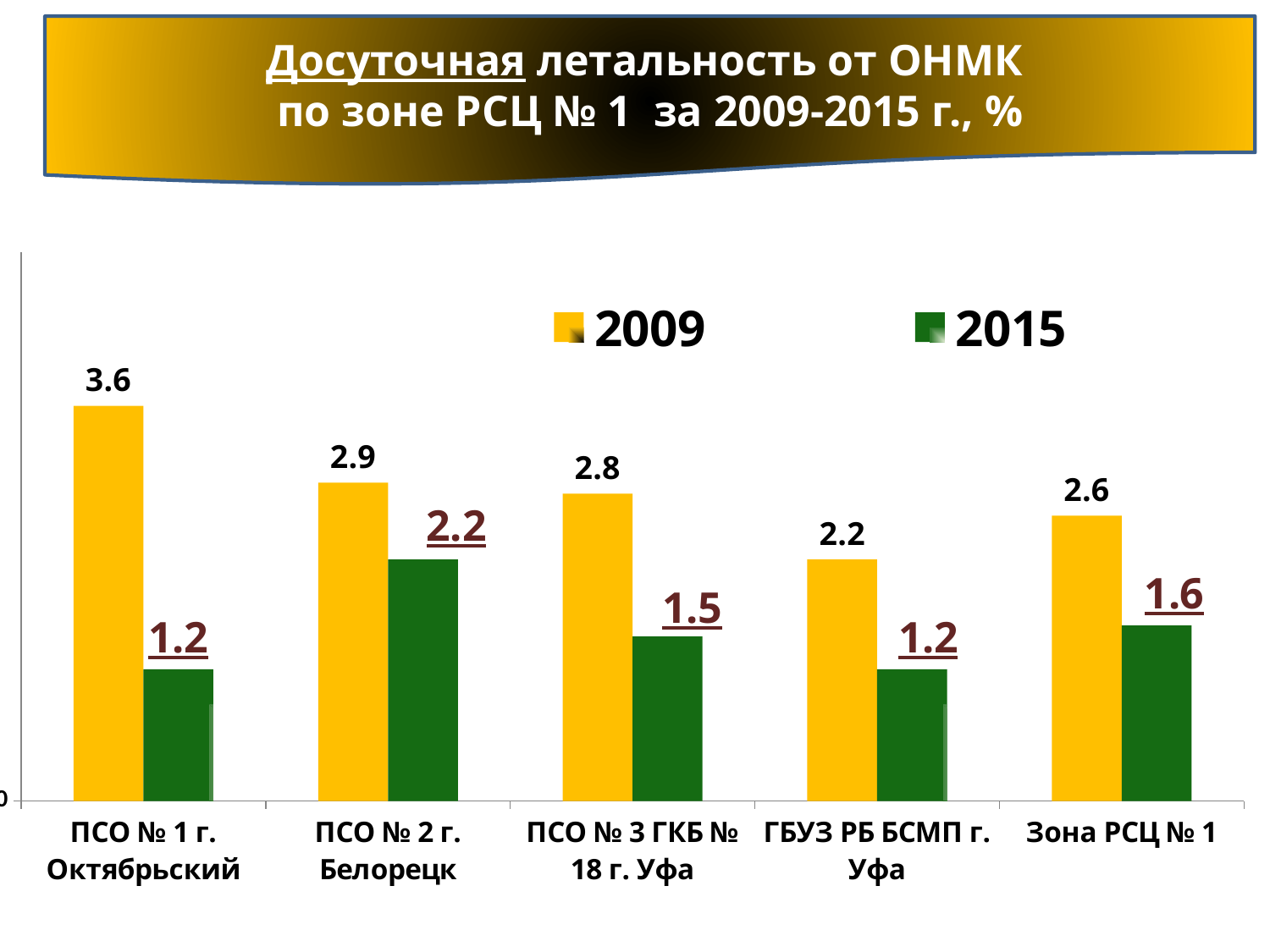
Which category has the highest 2015 value? ПСО № 2 г. Белорецк What is the 2015 value for ПСО № 2 г. Белорецк? 2.2 What is the difference between the 2009 and 2015 values for ПСО № 3 ГКБ № 18 г. Уфа? 1.3 How many categories are shown on the x axis? 5 What is the difference between the 2009 and 2015 values for ПСО № 1 г. Октябрьский? 2.4 How many series does the legend list? 2 What is the 2009 value for ГБУЗ РБ БСМП г. Уфа? 2.2 Which is larger: the 2015 value for ПСО № 2 г. Белорецк or the 2015 value for Зона РСЦ № 1? ПСО № 2 г. Белорецк What is the 2015 value for Зона РСЦ № 1? 1.6 Which category has the lowest 2009 value? ГБУЗ РБ БСМП г. Уфа What is the 2009 value for ПСО № 1 г. Октябрьский? 3.6 Which category has the highest 2009 value? ПСО № 1 г. Октябрьский